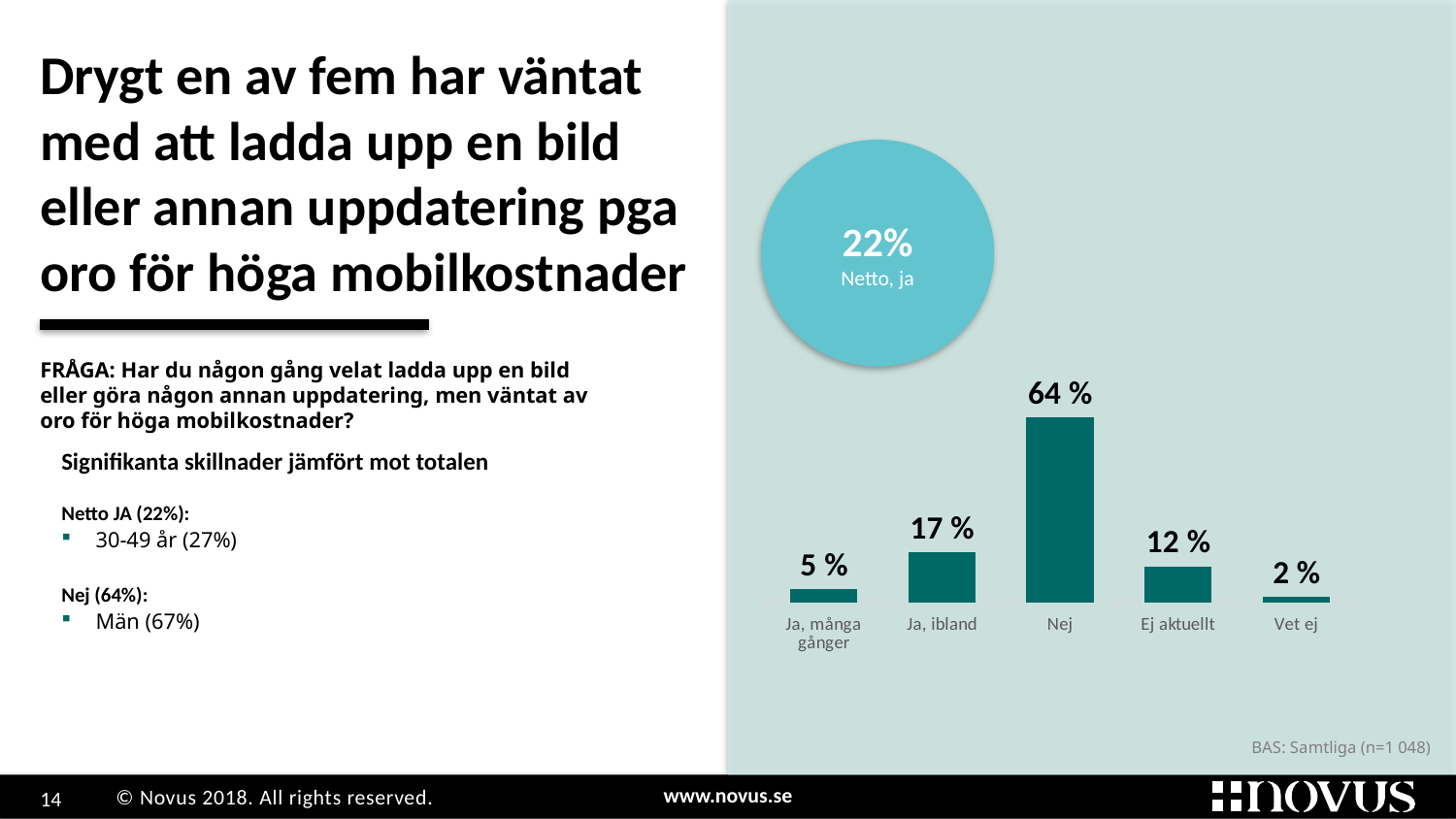
What is the value for "Ja, många gånger"? 5 % How many categories are shown on the x axis of the bar chart? 5 What value is shown in the circle labelled "Netto, ja"? 22% Which category has the highest value? Nej What is the value for "Vet ej"? 2 % What kind of chart is shown on the slide? Bar chart What is the difference between the values for "Nej" and "Ja, ibland"? 47 % What is the value for "Ja, ibland"? 17 % Which category has the lowest value? Vet ej What is the value for "Ej aktuellt"? 12 % Which is larger, the value for "Ej aktuellt" or the value for "Ja, många gånger"? Ej aktuellt What is the value for "Nej"? 64 %